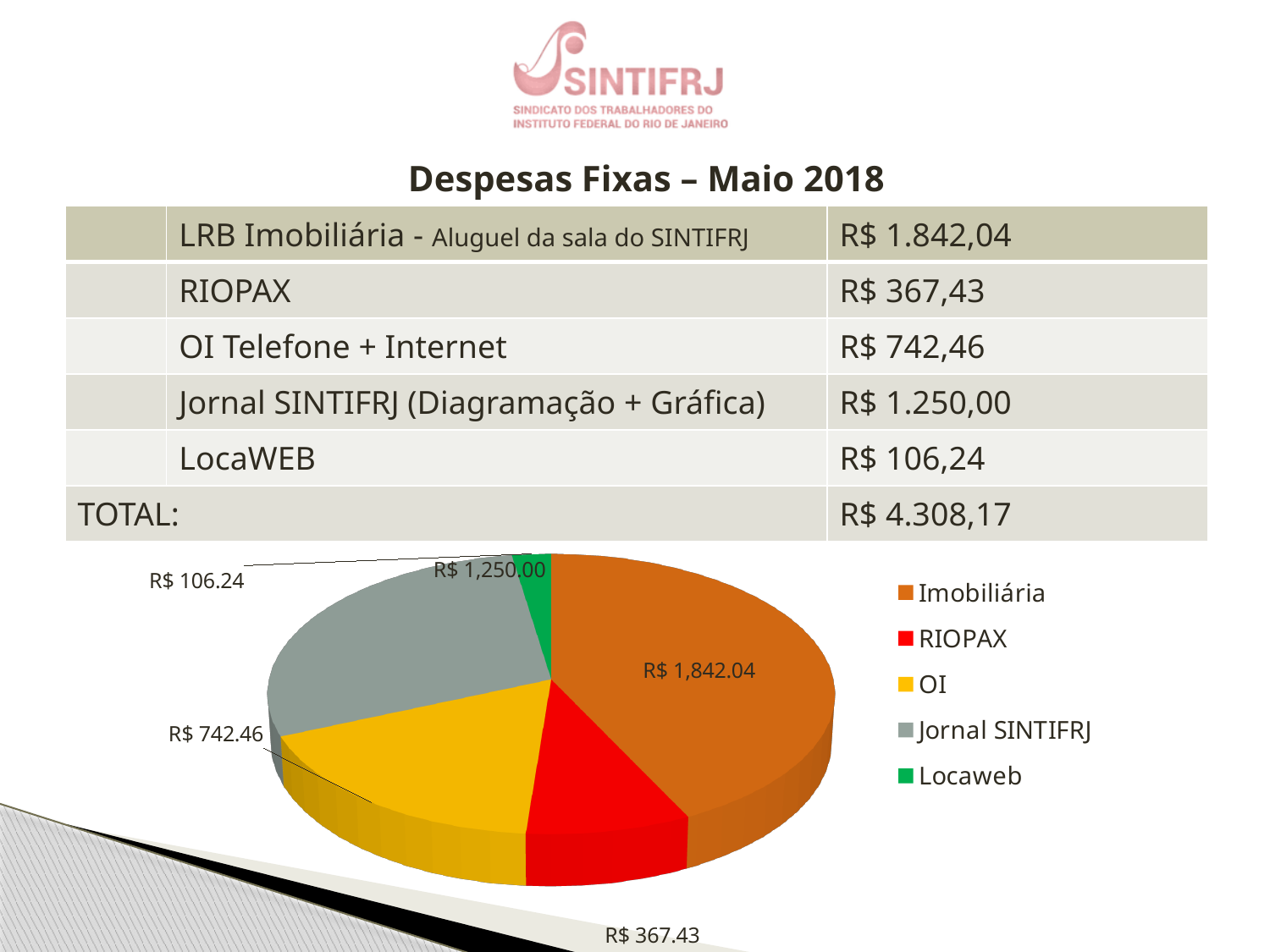
What is the difference between the OI value and the RIOPAX value in the pie chart? R$ 375.03 What colour represents Jornal SINTIFRJ in the pie chart legend? Grey What value is shown for the OI slice of the pie chart? R$ 742.46 Which category has the largest slice in the pie chart? Imobiliária What kind of chart is shown on the slide? Pie chart What value is shown for the Imobiliária slice of the pie chart? R$ 1,842.04 What is the difference between the Imobiliária value and the Jornal SINTIFRJ value in the pie chart? R$ 592.04 What value is shown for the Locaweb slice of the pie chart? R$ 106.24 Which is larger in the pie chart, the RIOPAX slice or the OI slice? OI How many slices does the pie chart have? 5 Which category has the smallest slice in the pie chart? Locaweb How many entries does the legend of the pie chart list? 5